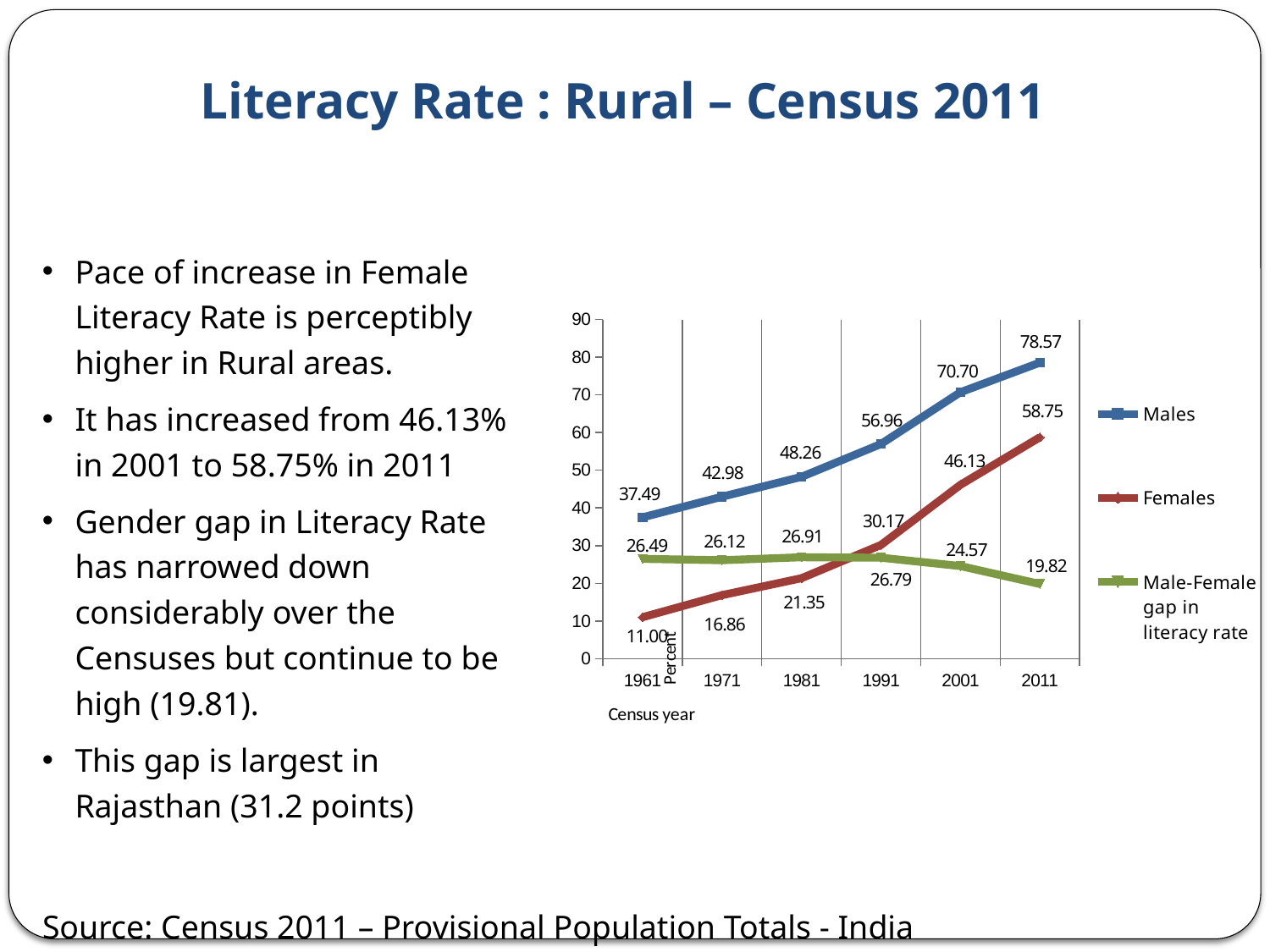
Which is larger in 1981: the Females value or the Male-Female gap in literacy rate? Male-Female gap in literacy rate Does the Females series rise or fall from 1961 to 2011? Rise What is the value for Females in 1961? 11.00 What is the value for Males in 2011? 78.57 What type of chart is shown on the slide? Line chart How many census years are plotted on the x axis? 6 How many series does the chart legend list? 3 In which census year is the Male-Female gap in literacy rate lowest? 2011 In which census year is the Females value highest? 2011 What is the Male-Female gap in literacy rate in 2001? 24.57 What is the difference between the Males value and the Females value in 1991? 26.79 What label is shown on the x axis of the chart? Census year